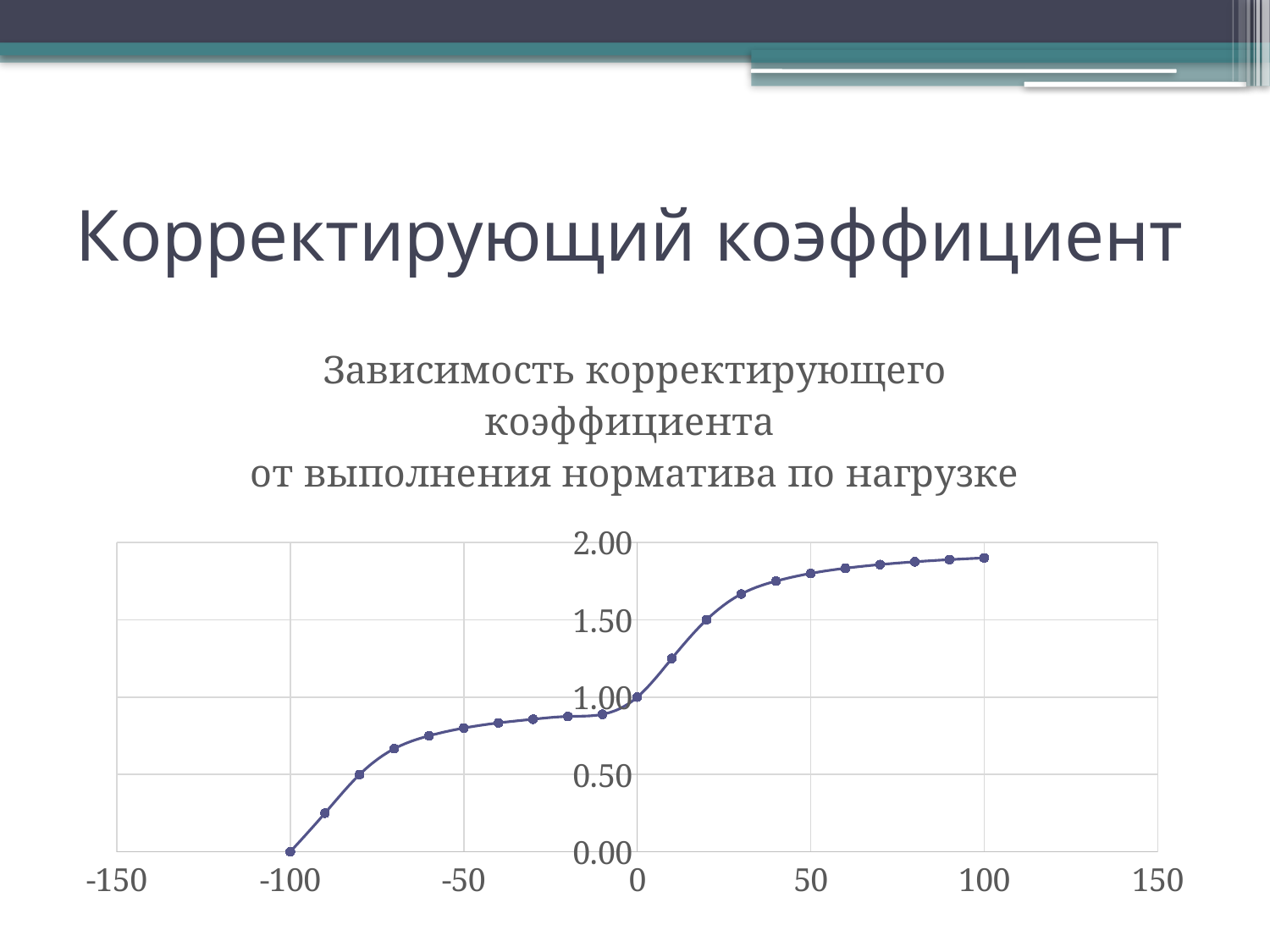
What is the value of the coefficient at x = 0? 1.00 Which is larger, the value at x = 10 or the value at x = -10? x = 10 Is the value at x = -90 greater or less than 0.50? less How many data points are plotted on the chart? 21 Do the values rise or fall as x increases along the x axis? rise What is the value of the coefficient at x = 20? 1.50 At which x value is the coefficient highest? 100 At which x value is the coefficient lowest? -100 What kind of chart is shown on the slide? line chart What is the value of the coefficient at x = -100? 0.00 What is the title of the chart? Зависимость корректирующего коэффициента от выполнения норматива по нагрузке Is the value at x = 50 greater or less than 1.50? greater